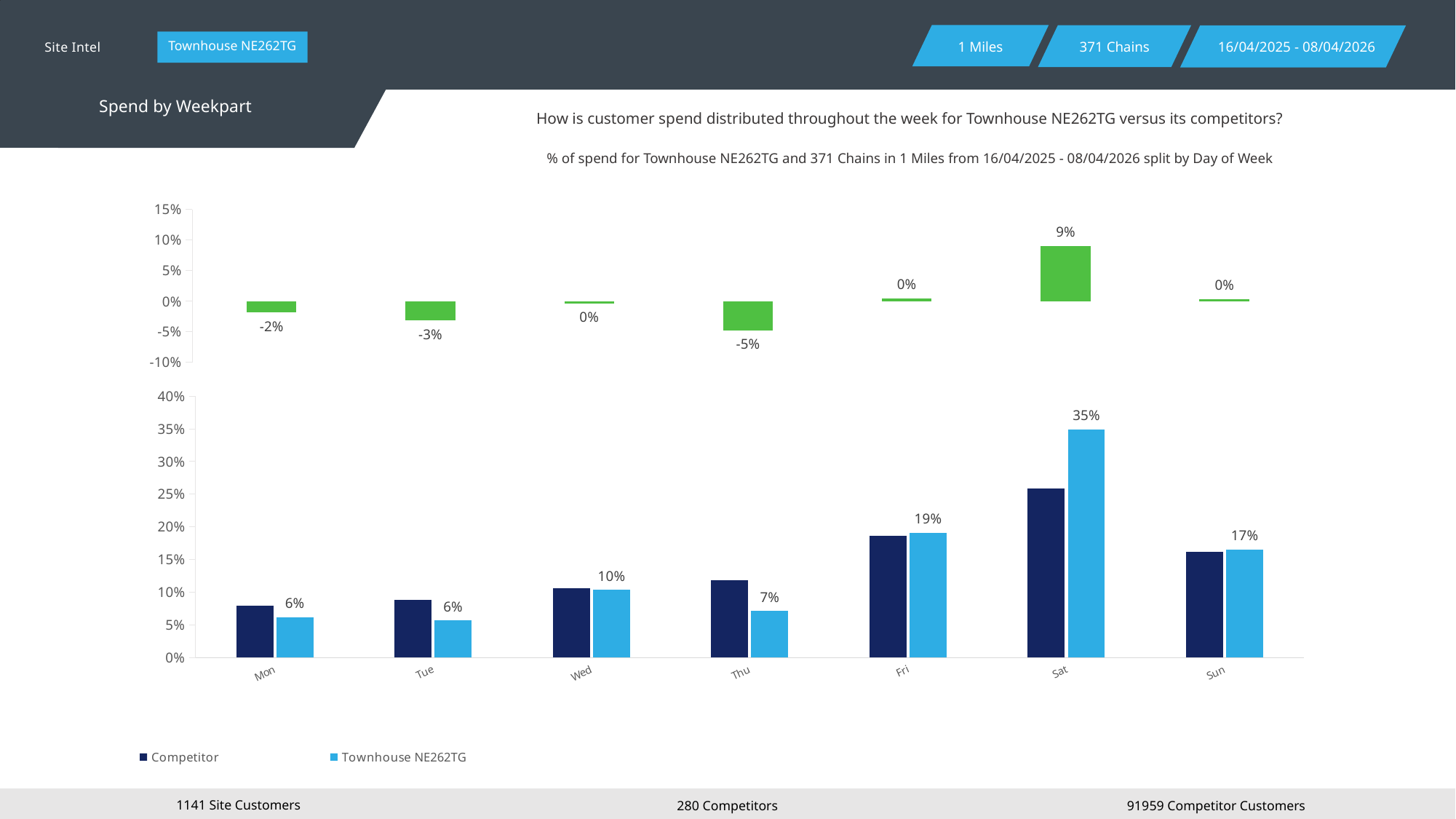
In the bottom chart, on Mon, which is larger: the Competitor bar or the Townhouse NE262TG bar? Competitor In the top chart, what is the value shown for Thu? -5% How many days of the week are shown on the x axis of the bottom chart? 7 In the bottom chart, which day has the highest value for Townhouse NE262TG? Sat What type of chart is the bottom chart? bar chart In the bottom chart, what is the value for Townhouse NE262TG on Sat? 35% How many series does the legend of the bottom chart list? 2 In the top chart, which day has the lowest value? Thu In the bottom chart, is the Competitor value for Sat greater or less than 20%? greater In the bottom chart, what is the difference between the Townhouse NE262TG values for Sat and Fri? 16% What are the two entries in the legend of the bottom chart? Competitor and Townhouse NE262TG In the bottom chart, is the Competitor value for Sun greater or less than 20%? less